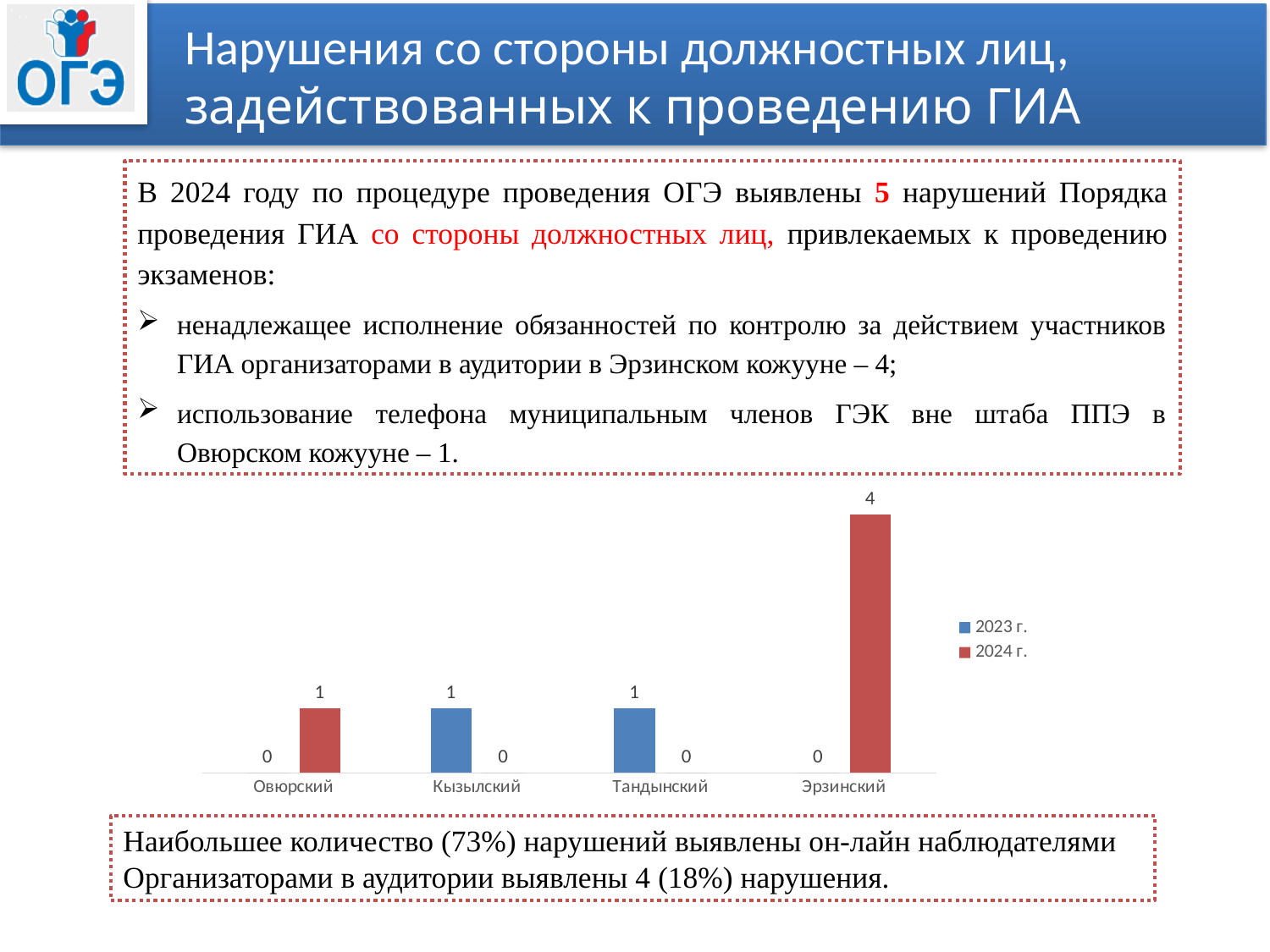
What is the difference between the 2024 г. value for Эрзинский and the 2024 г. value for Овюрский? 3 What type of chart is shown on the slide? bar chart What is the value for Эрзинский in the 2024 г. series? 4 How many categories (districts) are shown on the x axis of the chart? 4 Which is larger: the 2023 г. value for Кызылский or the 2024 г. value for Эрзинский? 2024 г. value for Эрзинский Which colour represents the 2024 г. series in the chart? red What is the value for Кызылский in the 2023 г. series? 1 What is the value for Овюрский in the 2024 г. series? 1 What is the value for Тандынский in the 2024 г. series? 0 Which category has the highest value in the 2024 г. series? Эрзинский What is the total of the 2023 г. and 2024 г. values for Тандынский? 1 How many series does the chart legend list? 2